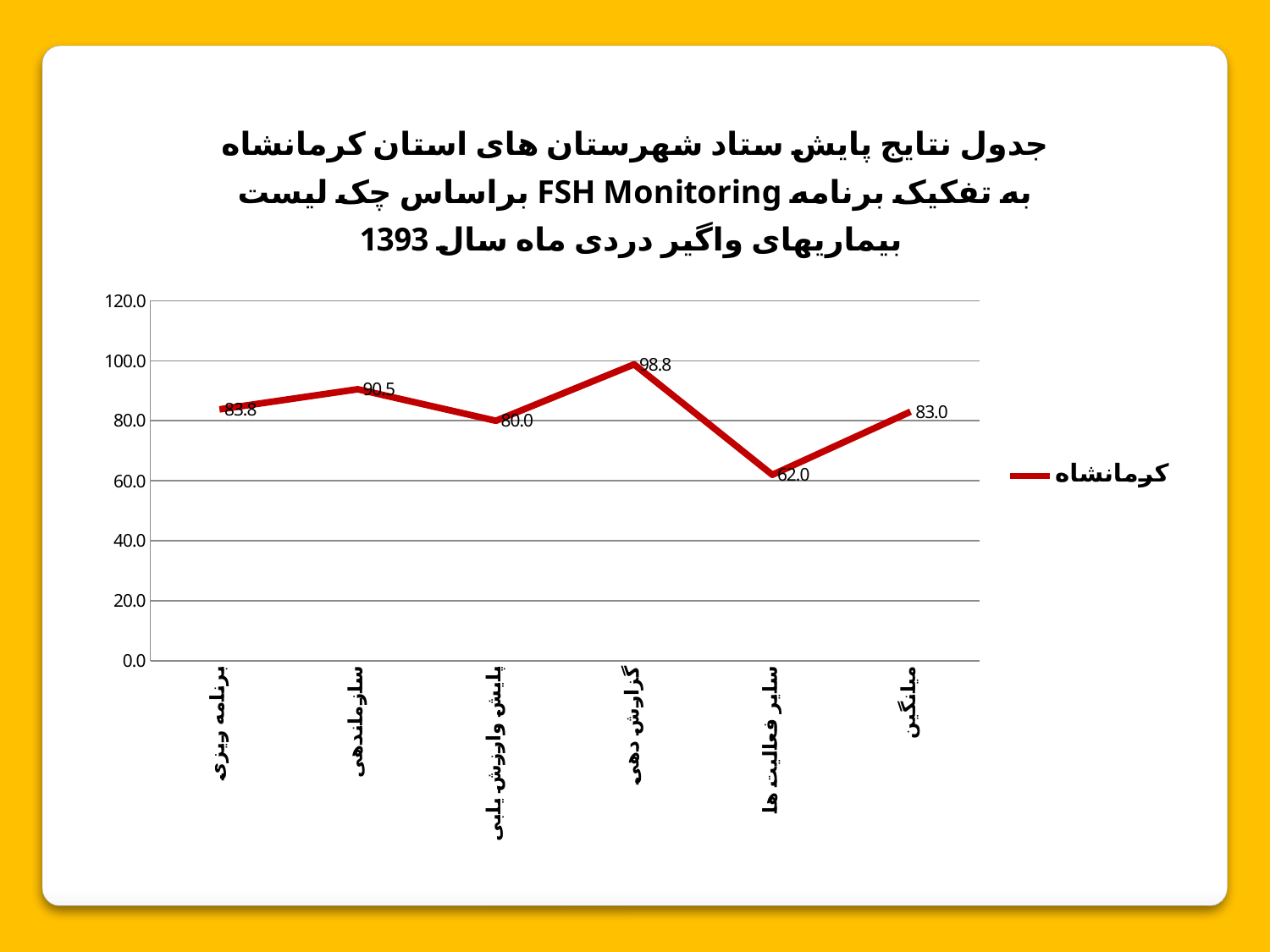
What is the value for برنامه ریزی? 83.8 Which category has the highest value? گزارش دهی What is the value for گزارش دهی? 98.8 Which category has the lowest value? سایر فعالیت ها What is the value for سازماندهی? 90.5 What is the difference between the values for گزارش دهی and سایر فعالیت ها? 36.8 Which is larger, the value for سازماندهی or the value for پایش و ارزش یابی? سازماندهی What is the value for سایر فعالیت ها? 62.0 What is the value for میانگین? 83.0 What type of chart is shown on the slide? line chart What series name does the legend show? کرمانشاه How many categories are plotted on the x axis? 6